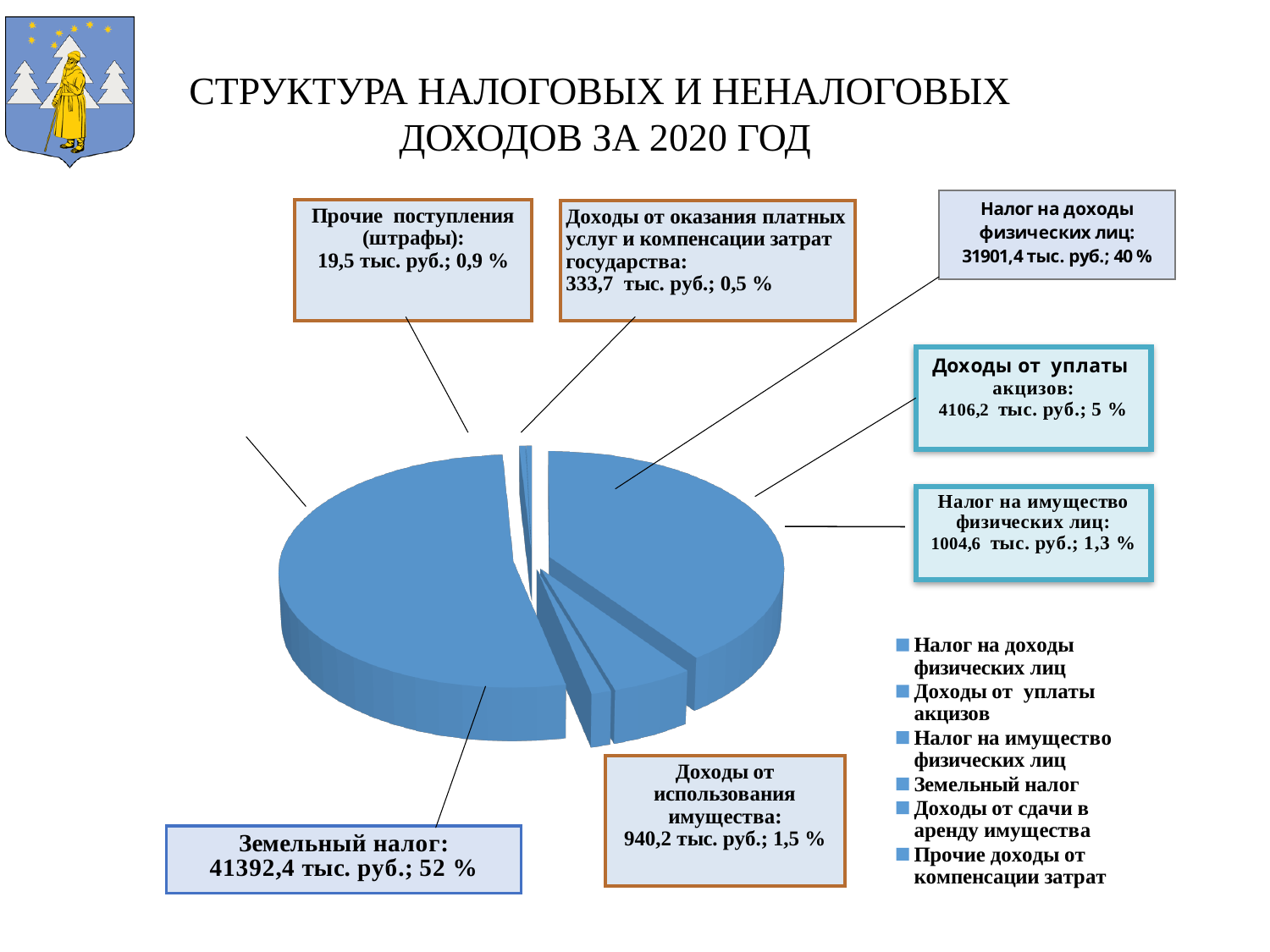
Which is larger: the share for Доходы от уплаты акцизов or the share for Доходы от использования имущества? Доходы от уплаты акцизов What share of the pie does Налог на имущество физических лиц represent? 1,3 % What share of the pie does Налог на доходы физических лиц represent? 40 % Which category has the largest share of the pie? Земельный налог What is the difference in percentage share between Земельный налог and Налог на доходы физических лиц? 12 % Which category has the smallest value in thousand rubles? Прочие поступления (штрафы) What is the title of the chart? СТРУКТУРА НАЛОГОВЫХ И НЕНАЛОГОВЫХ ДОХОДОВ ЗА 2020 ГОД What is the value for Земельный налог in thousand rubles? 41392,4 тыс. руб. What is the value for Доходы от уплаты акцизов in thousand rubles? 4106,2 тыс. руб. What kind of chart is shown on the slide? pie chart What is the value for Налог на доходы физических лиц in thousand rubles? 31901,4 тыс. руб. How many entries does the legend list? 6